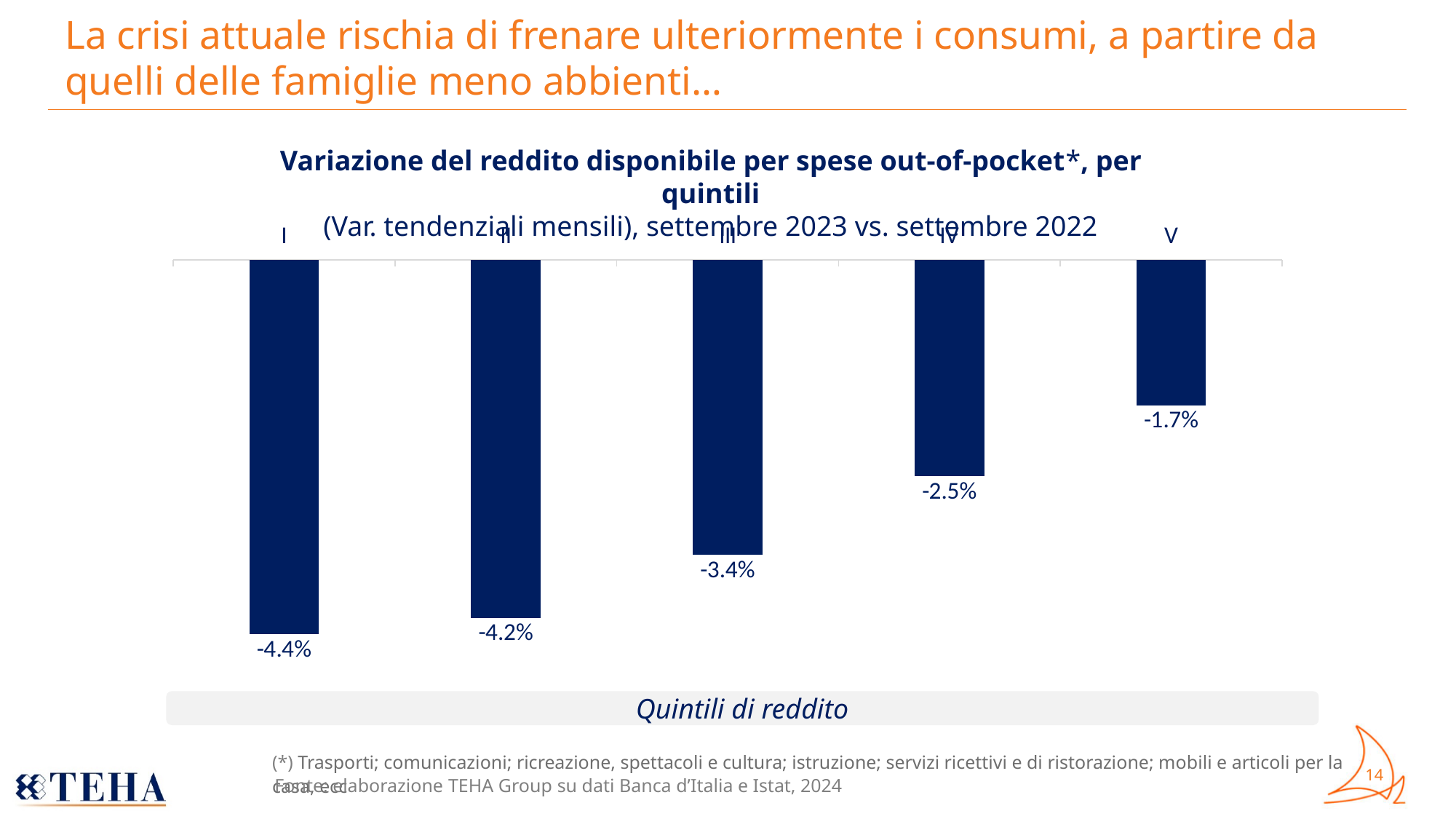
What kind of chart is shown on the slide? Bar chart What is the value for quintile IV? -2.5% Do the values rise or fall moving from quintile I to quintile V? Rise How many quintiles are shown in the chart? 5 Which quintile has the highest value (smallest decline)? V What is the value for quintile V? -1.7% What is the difference between the values for quintile II and quintile IV? 1.7 percentage points What is the difference between the values for quintile I and quintile V? 2.7 percentage points Which has a larger decline, quintile II or quintile III? Quintile II Which quintile has the lowest value (largest decline)? I What is the value for quintile III? -3.4% What is the value for quintile I? -4.4%